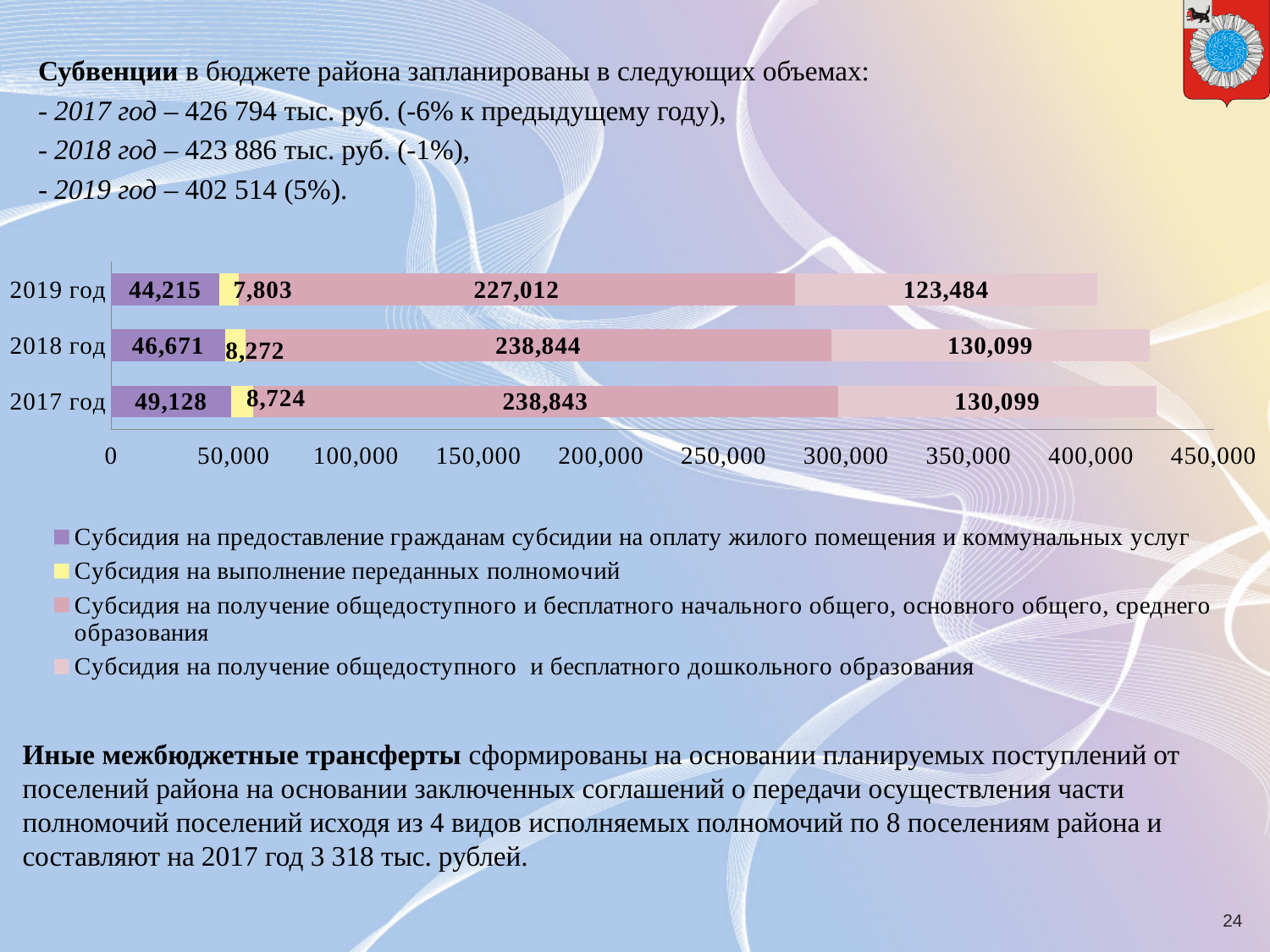
Which year has the highest value for 'Субсидия на предоставление гражданам субсидии на оплату жилого помещения и коммунальных услуг'? 2017 год What is the value of 'Субсидия на получение общедоступного и бесплатного дошкольного образования' for 2018 год? 130,099 Which year has the lowest value for 'Субсидия на выполнение переданных полномочий'? 2019 год What is the value of 'Субсидия на получение общедоступного и бесплатного начального общего, основного общего, среднего образования' for 2019 год? 227,012 How many series does the chart legend list? 4 How many years (categories) are shown in the chart? 3 What is the difference between the 2018 and 2019 values for 'Субсидия на получение общедоступного и бесплатного начального общего, основного общего, среднего образования'? 11,832 What is the value of 'Субсидия на предоставление гражданам субсидии на оплату жилого помещения и коммунальных услуг' for 2019 год? 44,215 What is the total of the stacked bar for 2019 год? 402,514 What type of chart is shown on the slide? Stacked bar chart What is the value of 'Субсидия на выполнение переданных полномочий' for 2017 год? 8,724 Is the total of the stacked bar for 2017 год greater or less than 400,000? greater